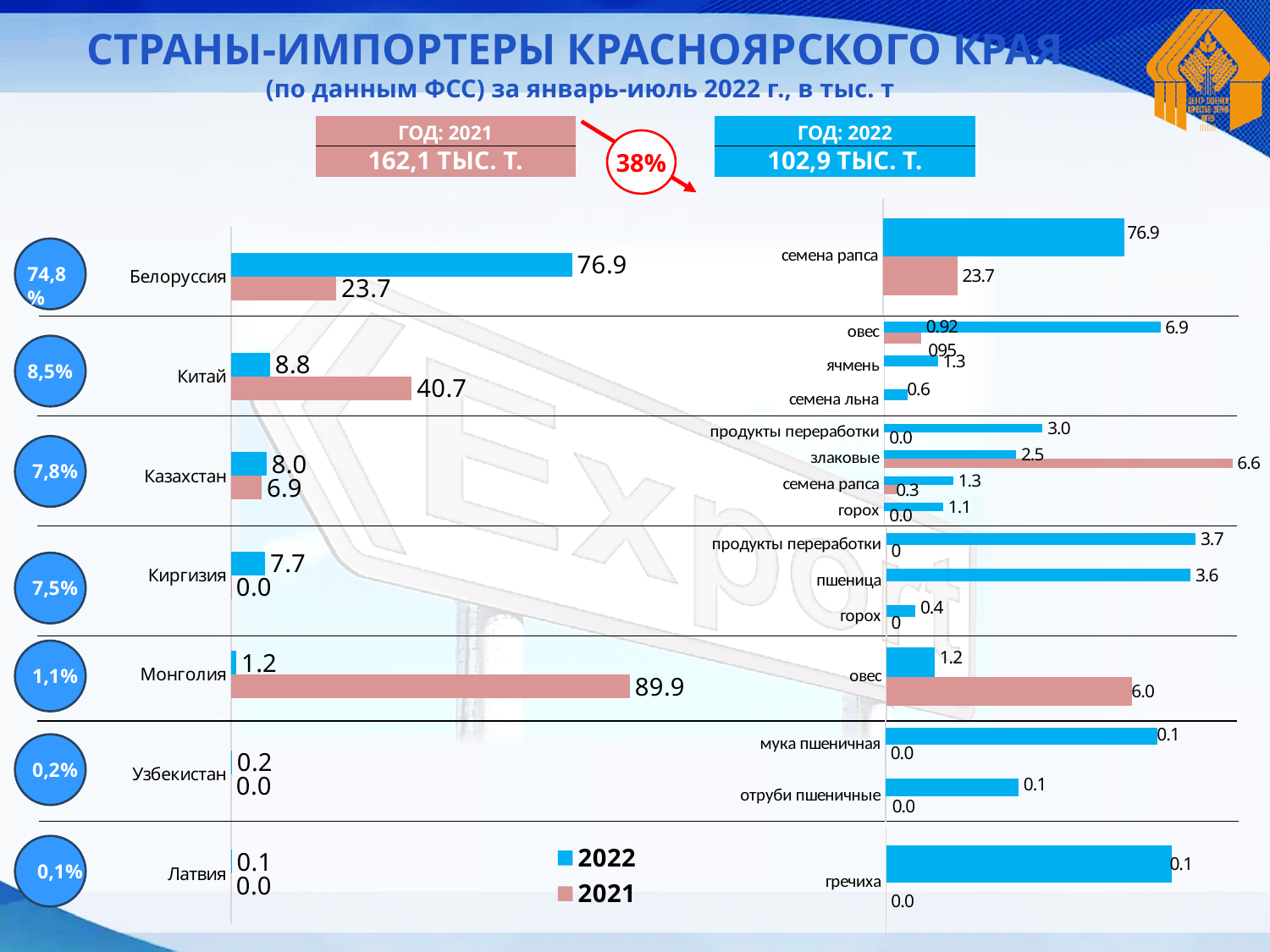
In the left chart of countries, which country has the highest 2022 value? Белоруссия What kind of chart is the left chart of countries? bar chart In the left chart of countries, what is the 2021 value for Монголия? 89.9 In the left chart of countries, what is the difference between the 2022 and 2021 values for Белоруссия? 53.2 In the left chart of countries, what is the 2022 value for Белоруссия? 76.9 In the right-hand chart for Монголия, what is the 2021 value for овес? 6.0 In the right-hand chart for Казахстан, what is the 2021 value for злаковые? 6.6 How many series does the legend list? 2 In the left chart of countries, what is the 2021 value for Китай? 40.7 In the right-hand chart for Киргизия, what is the 2022 value for пшеница? 3.6 In the left chart of countries, which country has the highest 2021 value? Монголия In the left chart of countries, which is larger for Казахстан: the 2022 value or the 2021 value? 2022